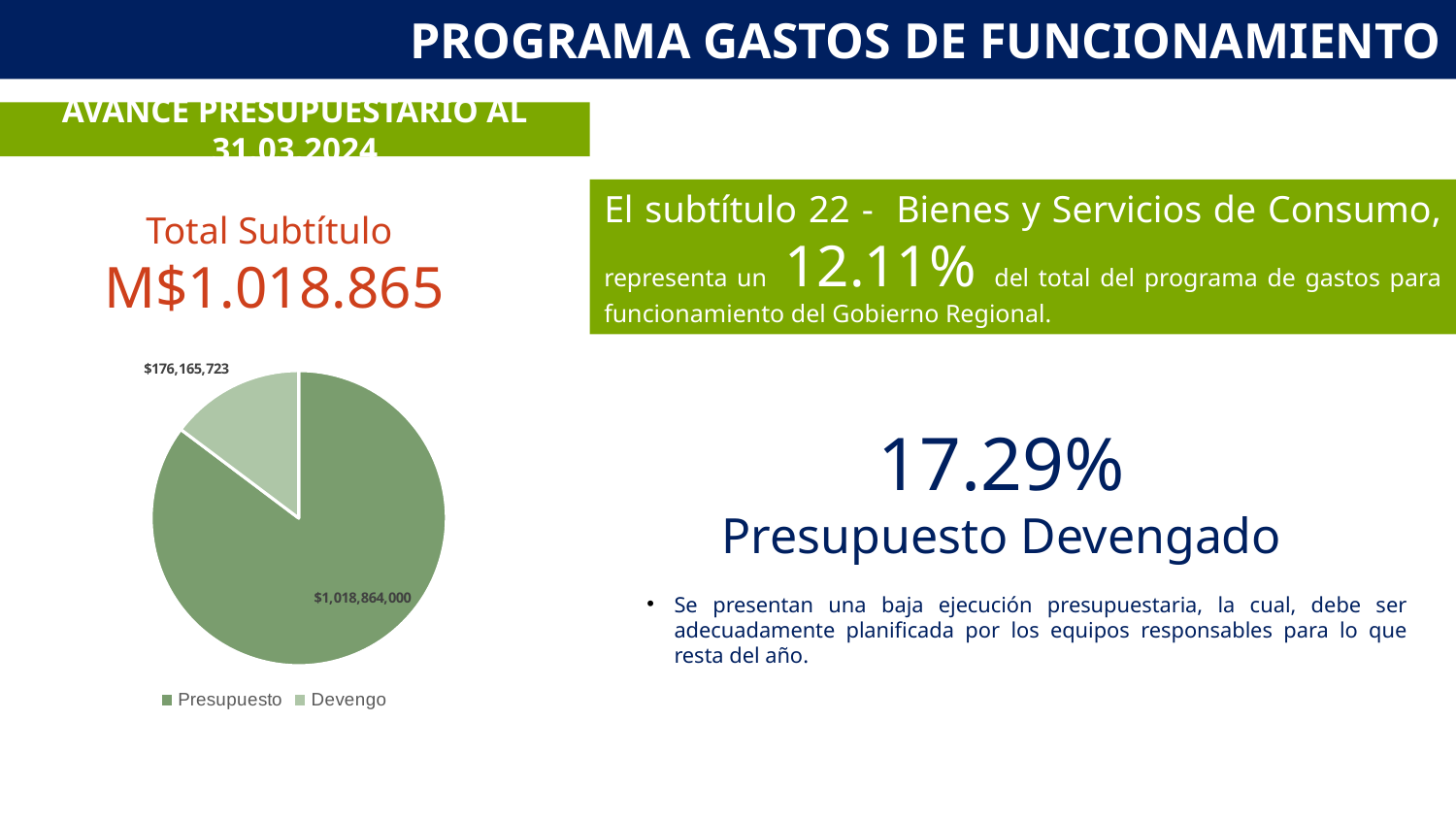
What is the total of the two values shown in the pie chart? $1,195,029,723 What is the value shown for Devengo in the pie chart? $176,165,723 Which slice of the pie chart is the largest? Presupuesto What is the difference between the Presupuesto value and the Devengo value in the pie chart? $842,698,277 What type of chart is shown on the slide? Pie chart What are the two legend entries of the pie chart? Presupuesto and Devengo Which is larger in the pie chart, Presupuesto or Devengo? Presupuesto How many entries does the legend of the pie chart list? 2 Which legend entry of the pie chart is shown in the lighter green colour? Devengo Which slice of the pie chart is the smallest? Devengo What is the value shown for Presupuesto in the pie chart? $1,018,864,000 How many slices does the pie chart have? 2